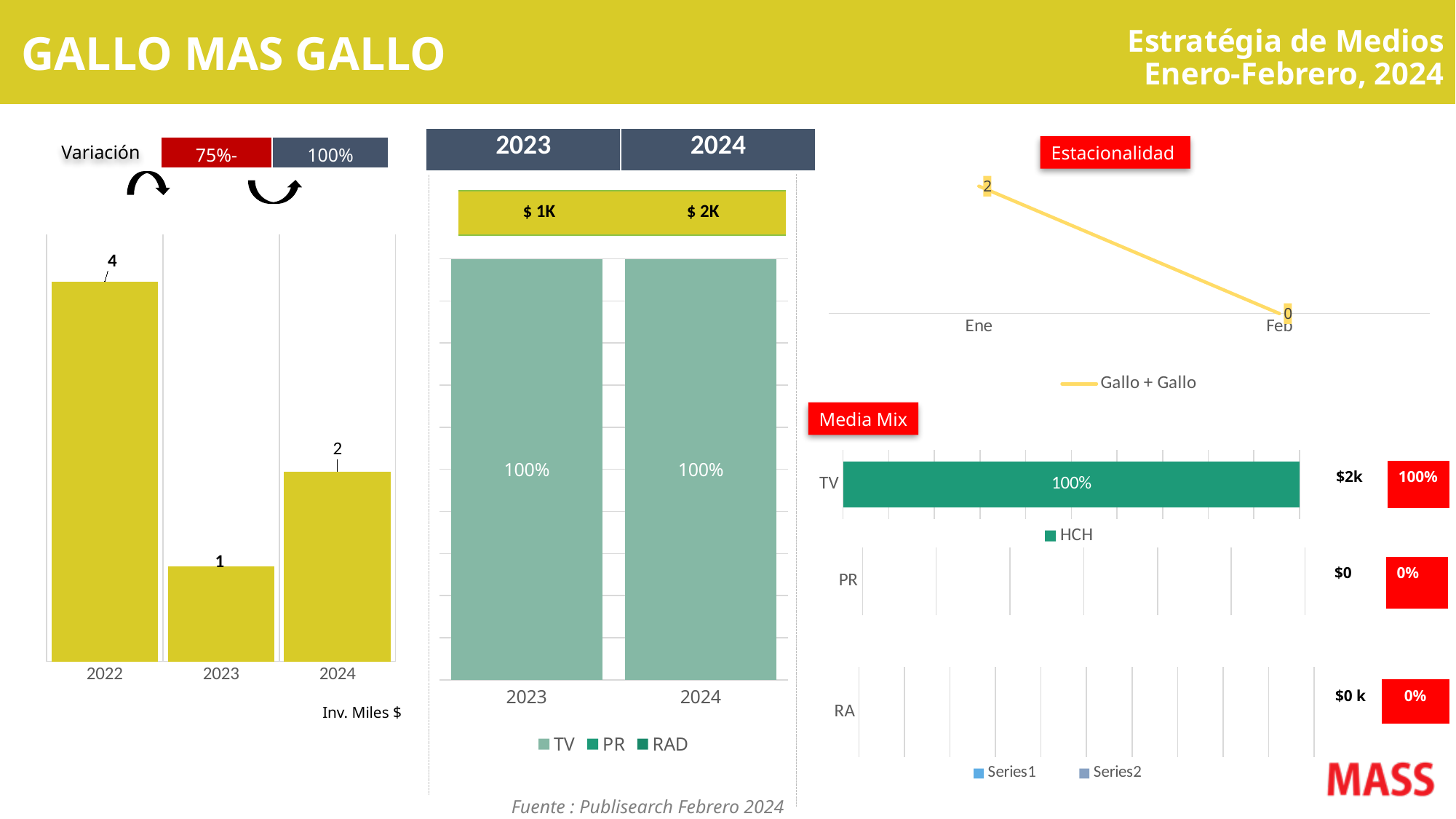
In the left bar chart (Inv. Miles $), how many years are shown? 3 In the middle stacked bar chart (2023 vs 2024), how many series does the legend list? 3 What kind of chart is the Estacionalidad chart? line chart In the left bar chart (Inv. Miles $), what is the value for 2022? 4 In the Estacionalidad chart, do the values rise or fall from Ene to Feb? fall In the left bar chart (Inv. Miles $), what is the value for 2024? 2 In the left bar chart (Inv. Miles $), which year has the lowest value? 2023 In the left bar chart (Inv. Miles $), which year has the highest value? 2022 In the Media Mix chart, what is the percentage shown for TV? 100% In the middle stacked bar chart (2023 vs 2024), what percentage does TV account for in 2024? 100% In the left bar chart (Inv. Miles $), what is the difference between the 2022 and 2024 values? 2 In the Estacionalidad chart, what is the value for Ene? 2